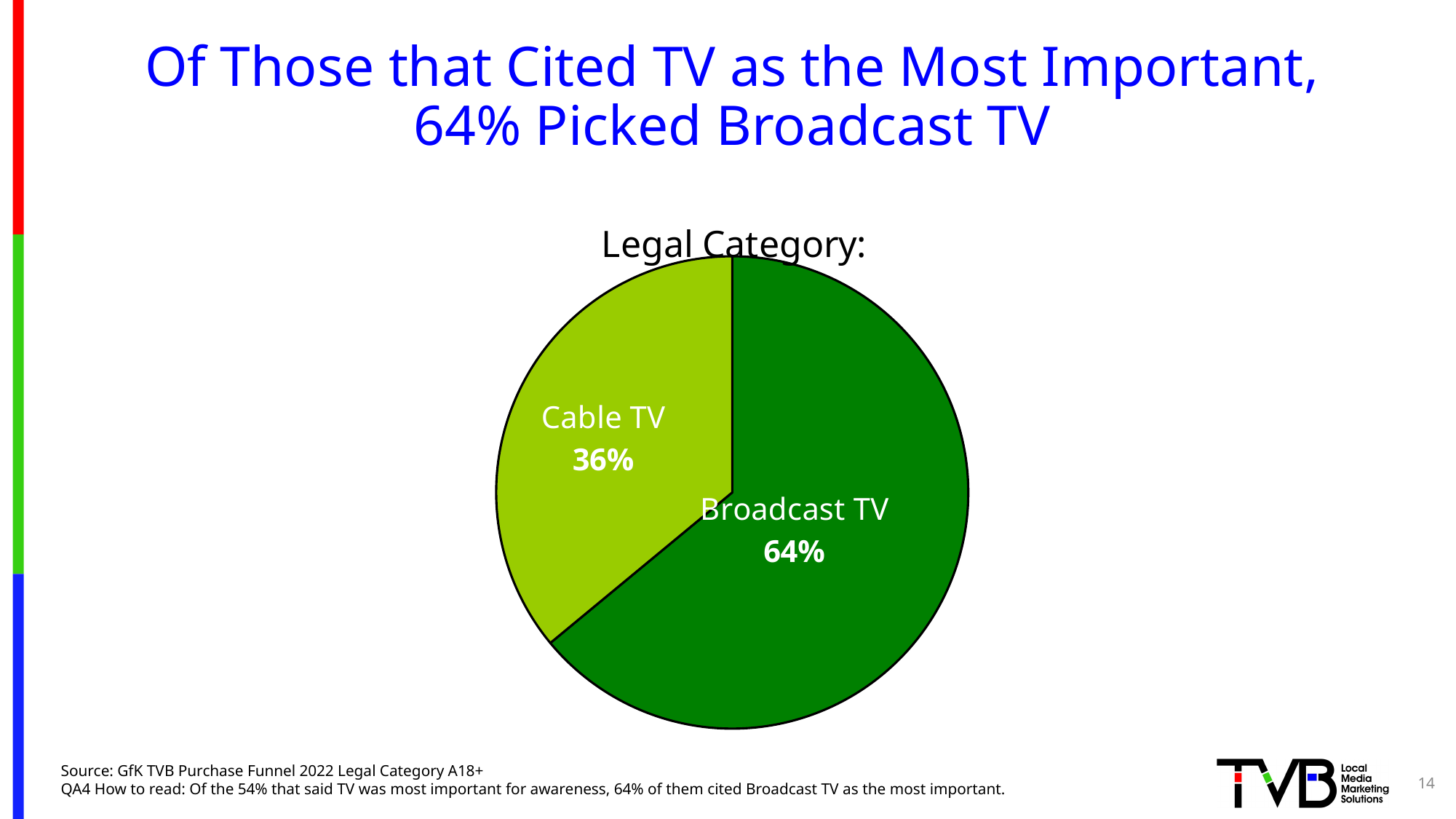
Which slice of the pie is the largest? Broadcast TV Which slice of the pie is the smallest? Cable TV Which is larger, the Broadcast TV slice or the Cable TV slice? Broadcast TV What is the difference in percentage points between Broadcast TV and Cable TV? 28 How many slices does the pie chart have? 2 What percentage of the pie is Cable TV? 36% Which slice is shown in the darker green colour? Broadcast TV What is the title of the pie chart? Legal Category: What kind of chart is shown on the slide? pie chart What share of the pie does Cable TV represent? 36% What percentage of the pie is Broadcast TV? 64%